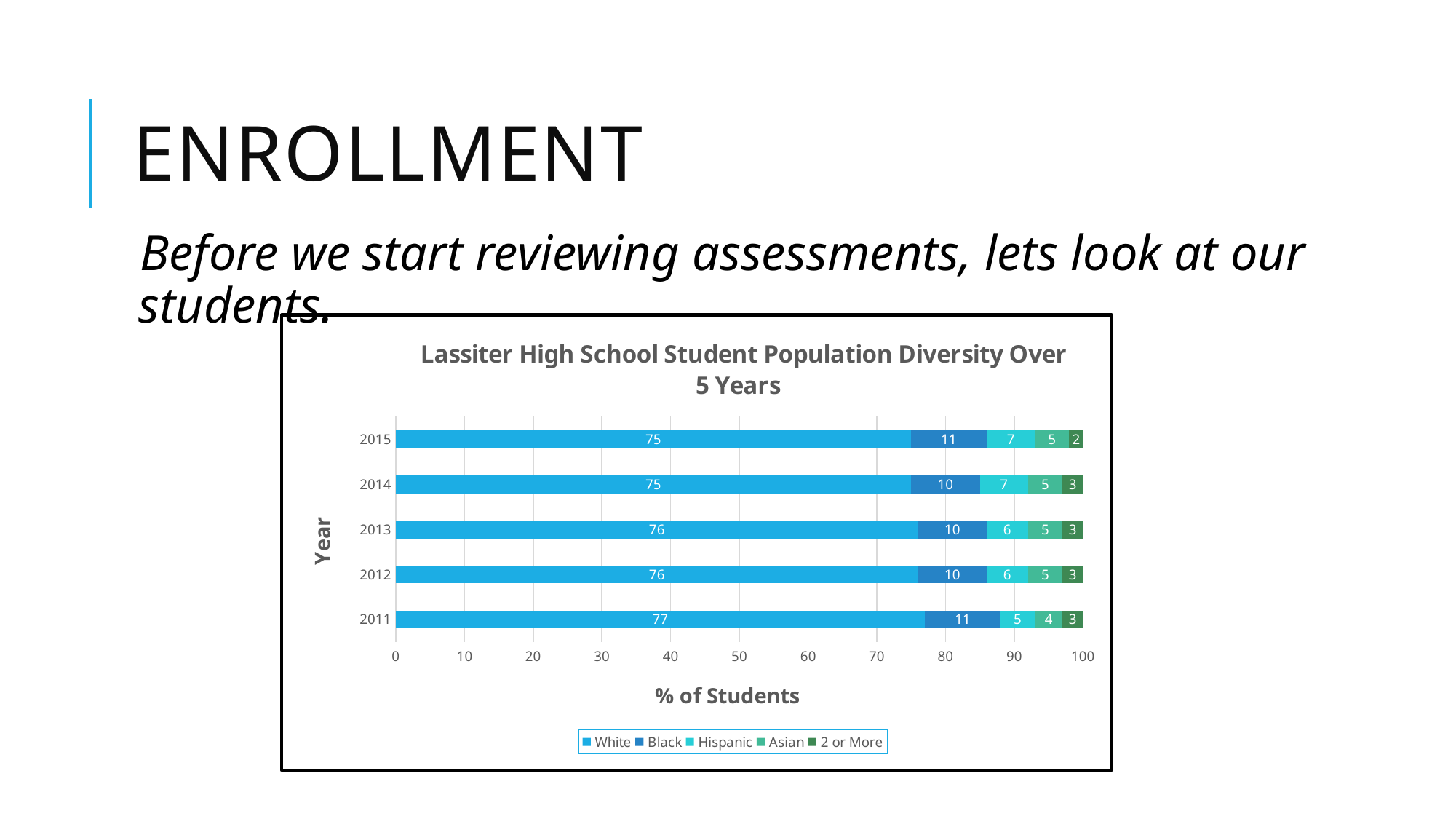
What is the total of the stacked bar for 2013? 100 Which year has the highest value for White? 2011 What is the value for White in 2011? 77 How many series does the legend list? 5 What is the value for 2 or More in 2015? 2 How many years are shown on the chart? 5 What is the value for Hispanic in 2015? 7 Which year has the lowest value for Hispanic? 2011 Which is larger, the Black value in 2015 or the Black value in 2014? 2015 What type of chart is shown on the slide? Stacked bar chart What is the title of the chart? Lassiter High School Student Population Diversity Over 5 Years What is the difference between the White value in 2011 and the White value in 2015? 2